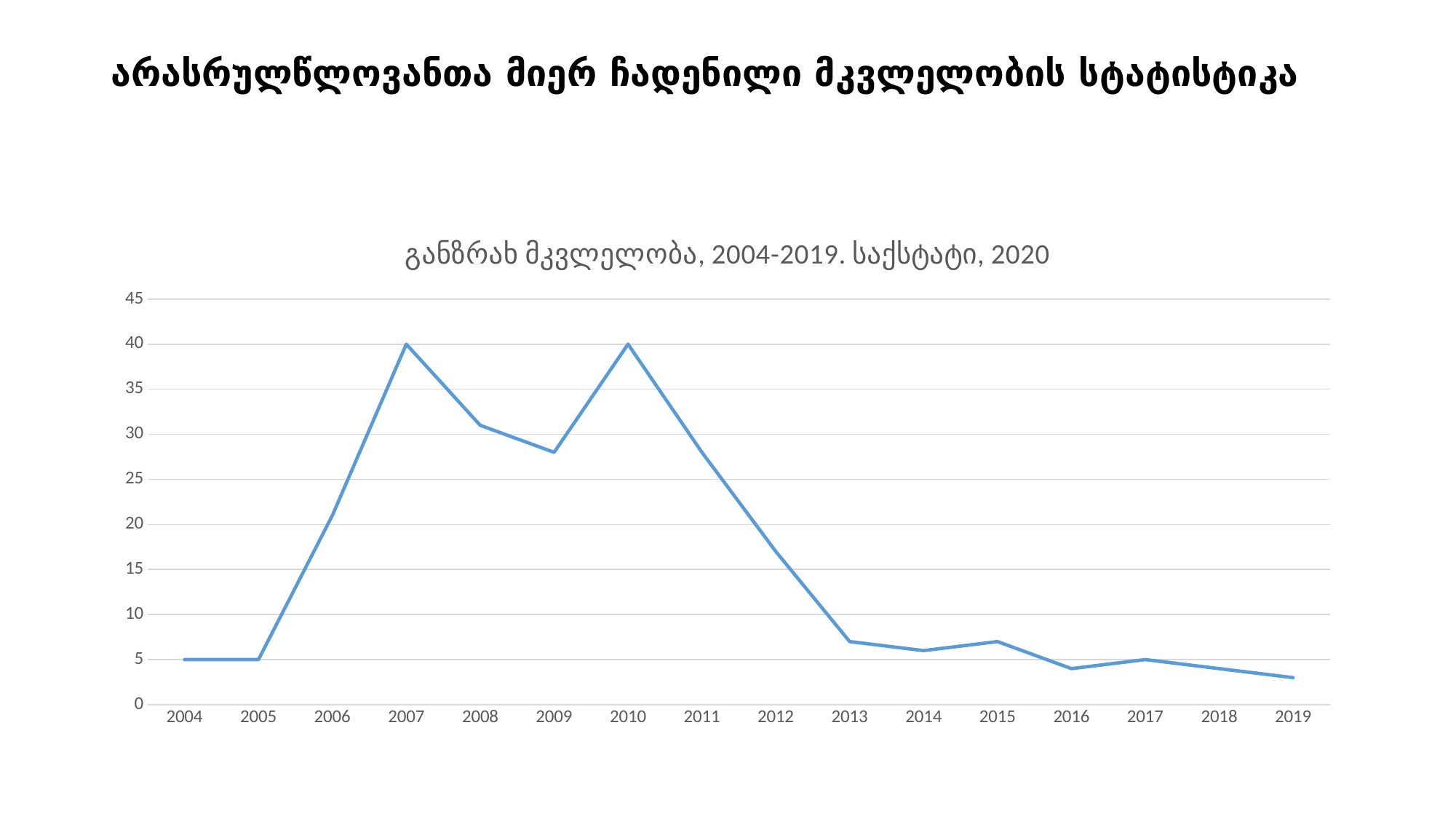
Is the value for 2006 greater or less than 15? greater What is the difference between the values for 2007 and 2004? 35 What is the value for 2004? 5 What is the value for 2007? 40 Is the value for 2011 greater or less than 20? greater What is the value for 2010? 40 How many years are plotted along the x axis of the chart? 16 Which year has the larger value, 2007 or 2013? 2007 Do the values rise or fall from 2010 to 2013? fall Is the value for 2012 greater or less than 20? less What is the title of the chart? განზრახ მკვლელობა, 2004-2019. საქსტატი, 2020 What kind of chart is shown on the slide? line chart